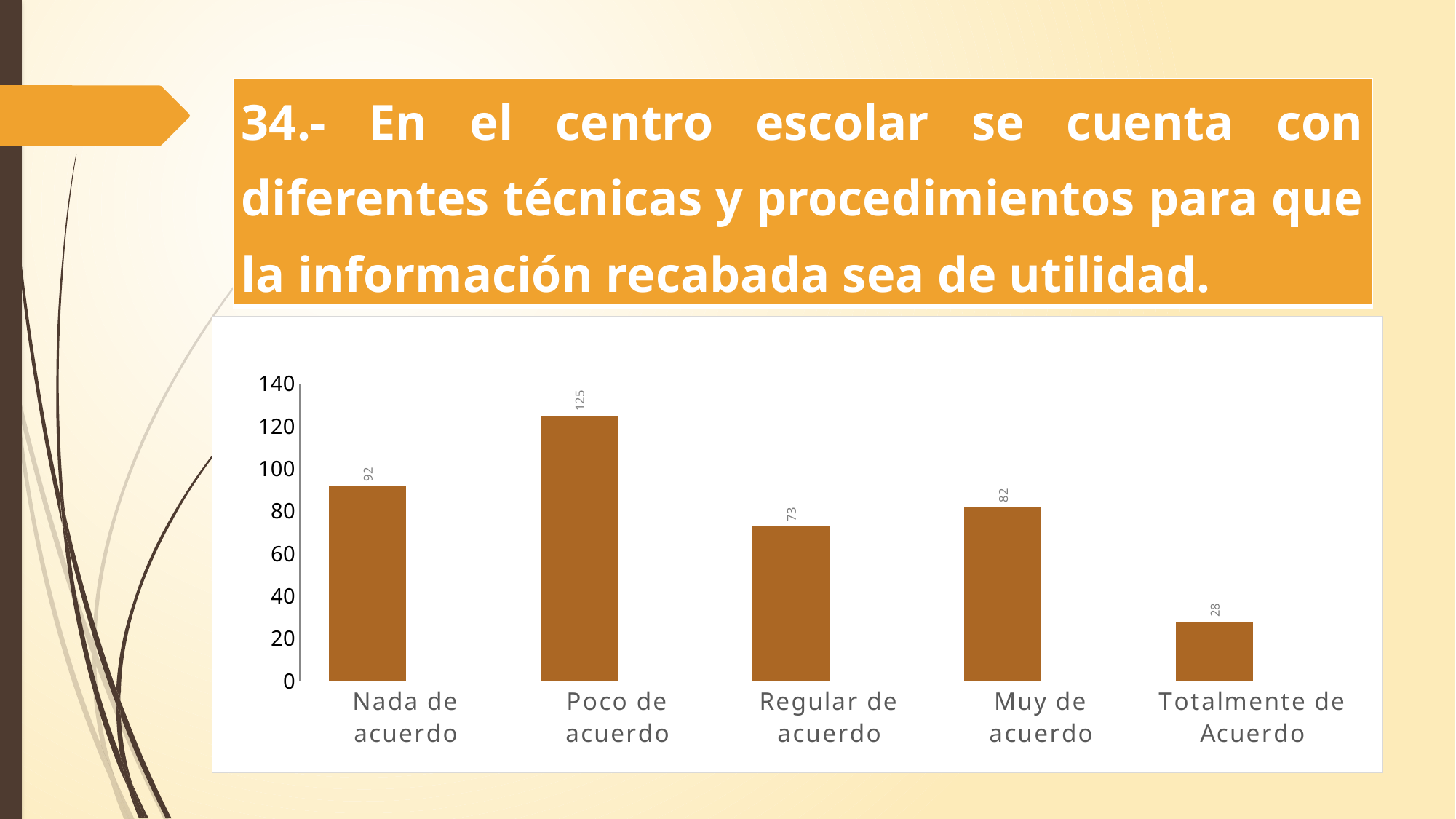
What kind of chart is shown on the slide? bar chart What is the highest value shown on the y axis? 140 Which is larger, the value for "Nada de acuerdo" or the value for "Muy de acuerdo"? Nada de acuerdo Which category has the lowest value? Totalmente de Acuerdo Is the value for "Muy de acuerdo" greater or less than 100? less What is the value for "Regular de acuerdo"? 73 Which category has the highest value? Poco de acuerdo What is the difference between the values for "Muy de acuerdo" and "Totalmente de Acuerdo"? 54 What is the value for "Totalmente de Acuerdo"? 28 What is the value for "Poco de acuerdo"? 125 What is the difference between the values for "Poco de acuerdo" and "Nada de acuerdo"? 33 How many categories are shown on the x axis? 5